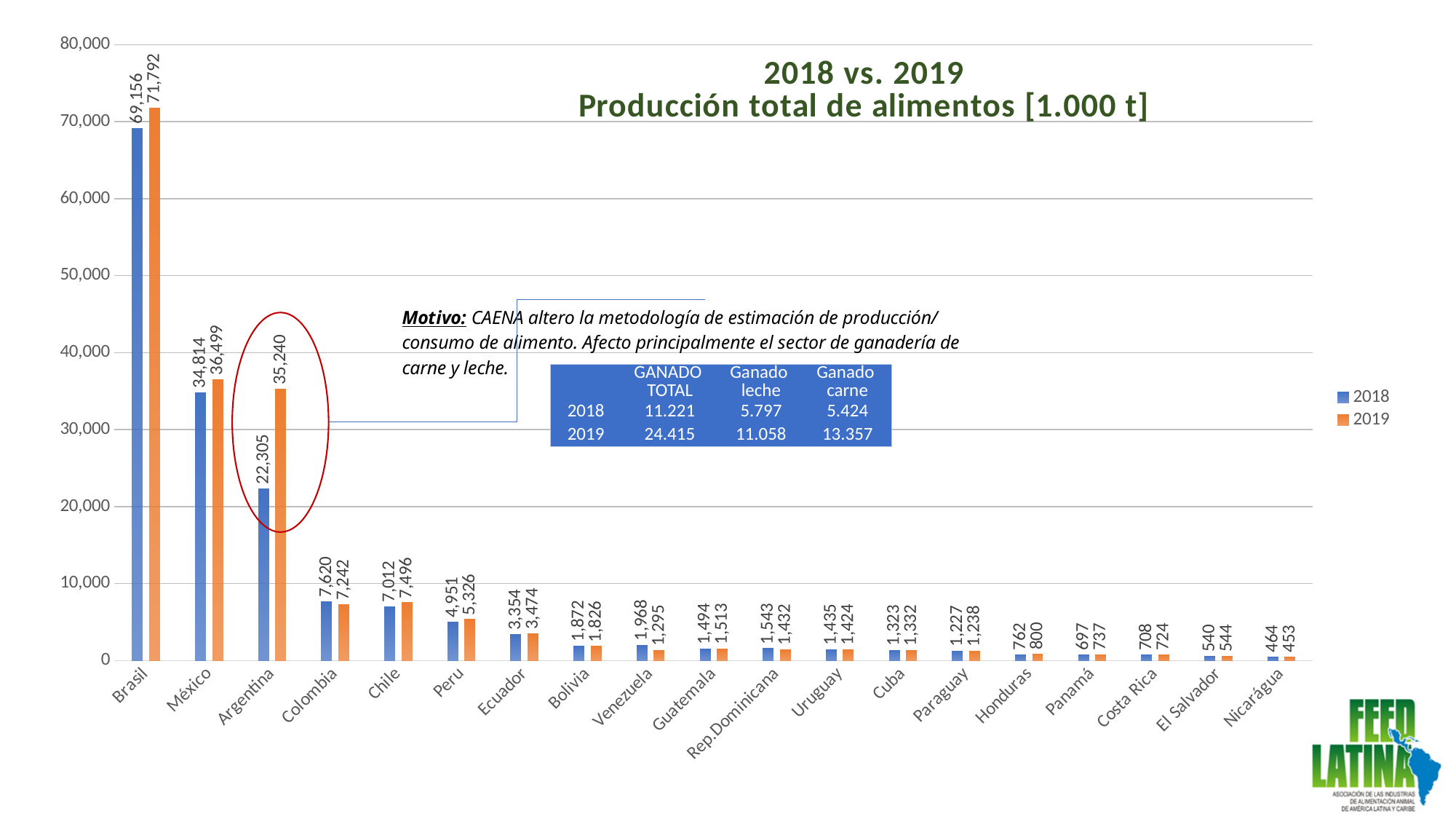
How many countries are shown on the x axis? 19 Which is larger for Colombia, the 2018 value or the 2019 value? 2018 What kind of chart is shown on the slide? Bar chart What is the difference between the 2019 and 2018 values for Brasil? 2,636 Which country has the lowest 2018 value? Nicarágua What is the 2018 value for Venezuela? 1,968 What is the 2019 value for Argentina? 35,240 How many series does the legend list? 2 What is the 2019 value for Colombia? 7,242 Which country has the highest 2019 value? Brasil What is the 2018 value for Brasil? 69,156 What is the difference between the 2019 and 2018 values for Argentina? 12,935